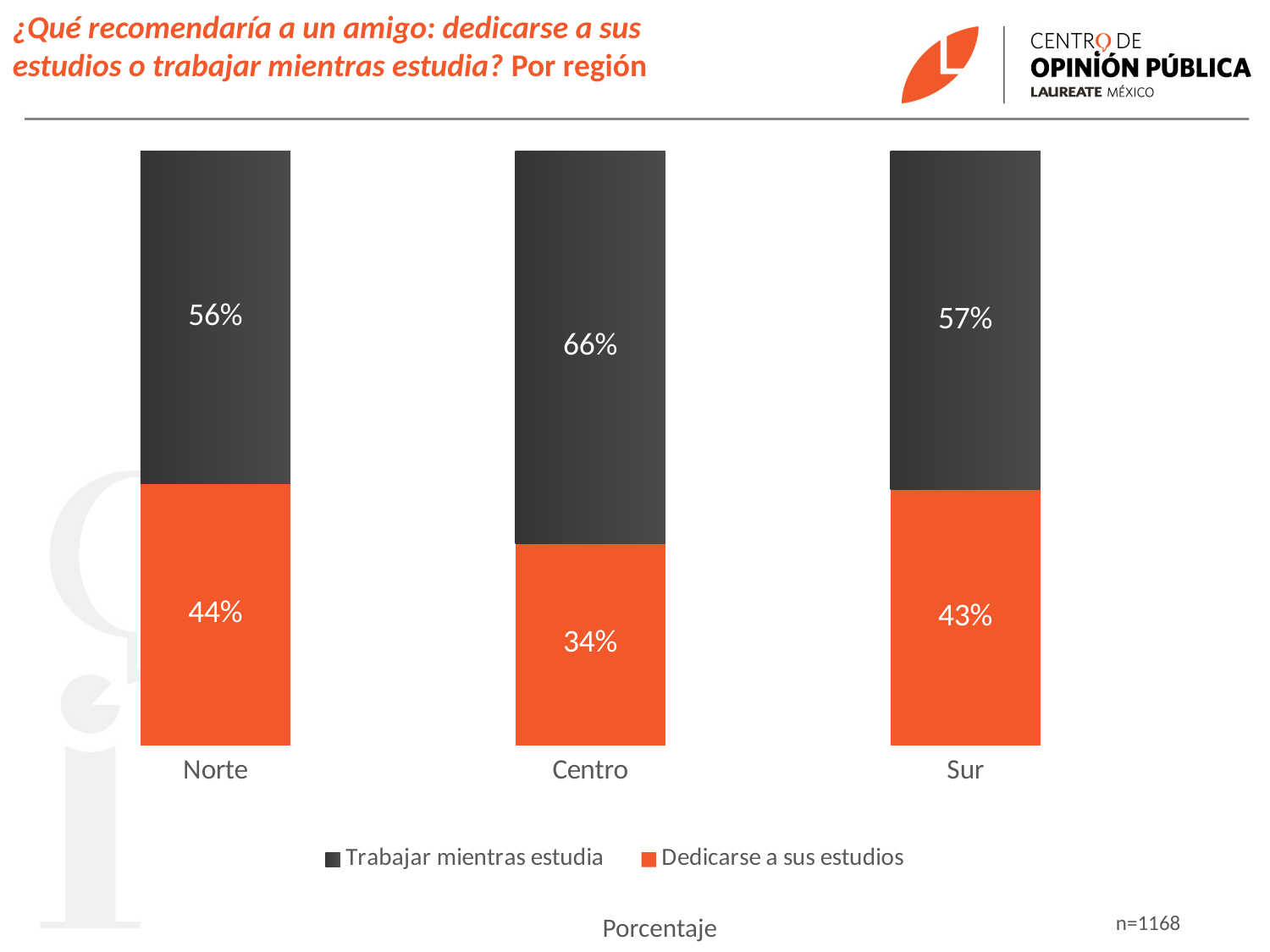
What is the value for "Dedicarse a sus estudios" in the Norte region? 44% What is the value for "Trabajar mientras estudia" in the Centro region? 66% Which region has the highest value for "Trabajar mientras estudia"? Centro What is the value for "Trabajar mientras estudia" in the Norte region? 56% How many regions are shown on the x axis? 3 Which region has the lowest value for "Dedicarse a sus estudios"? Centro What is the total of the stacked bar for the Sur region? 100% What kind of chart is shown on the slide? Stacked bar chart Which is larger: "Dedicarse a sus estudios" in Norte or in Centro? Norte What is the value for "Dedicarse a sus estudios" in the Sur region? 43% What is the difference between the "Trabajar mientras estudia" values for Centro and Norte? 10% How many series does the legend list? 2